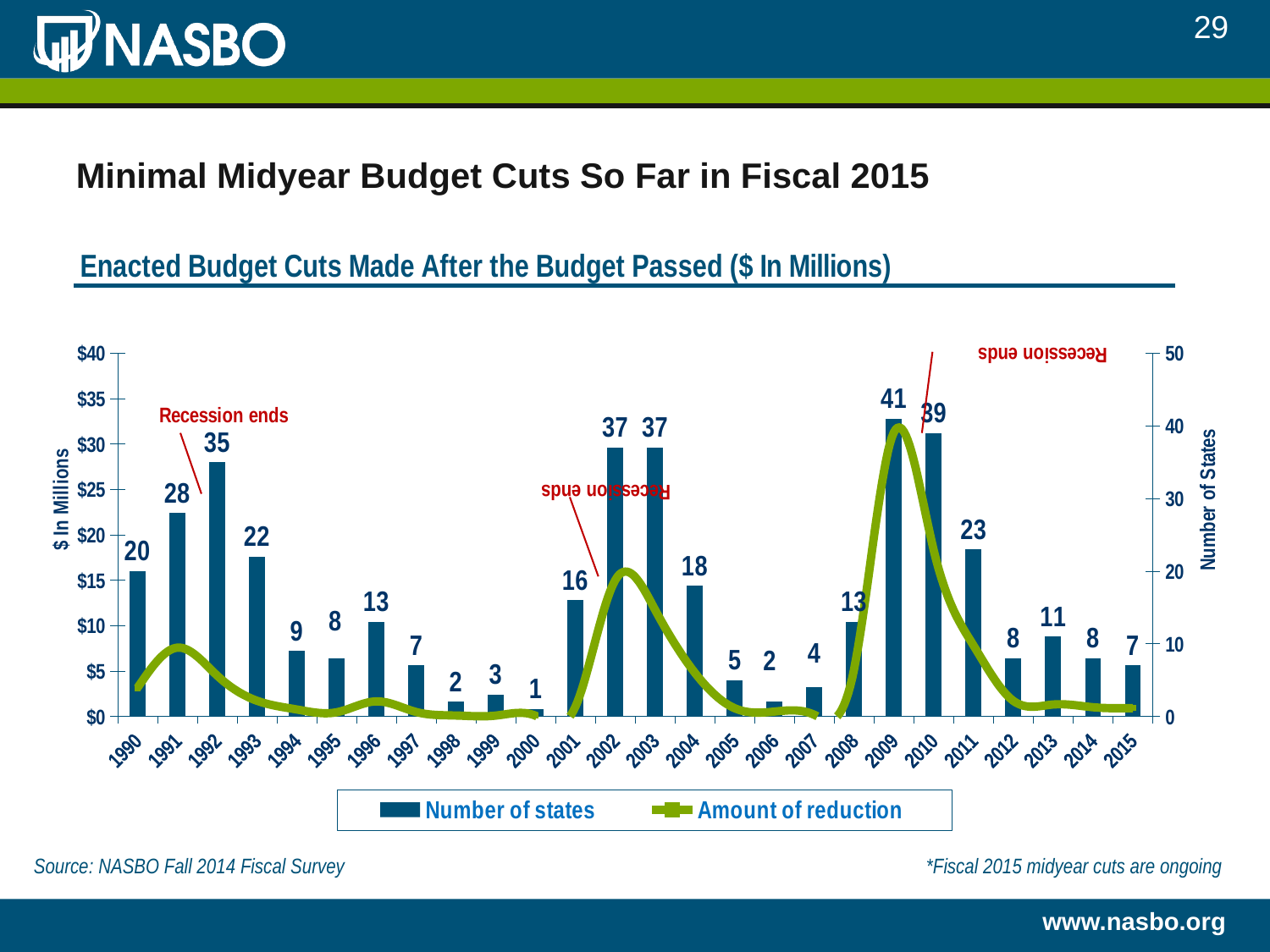
How many series does the legend list? 2 Is the amount of reduction for 2009 greater or less than $25? greater What is the number of states for 1992? 35 Which year has the lowest number of states? 2000 What kind of chart is this? Combined bar and line chart Is the amount of reduction for 1991 greater or less than $10? less Which year has a larger number of states, 1992 or 1993? 1992 Which year has the highest number of states? 2009 What is the number of states for 2009? 41 How many years are shown on the x axis? 26 What is the difference in the number of states between 2009 and 2010? 2 What is the number of states for 2001? 16